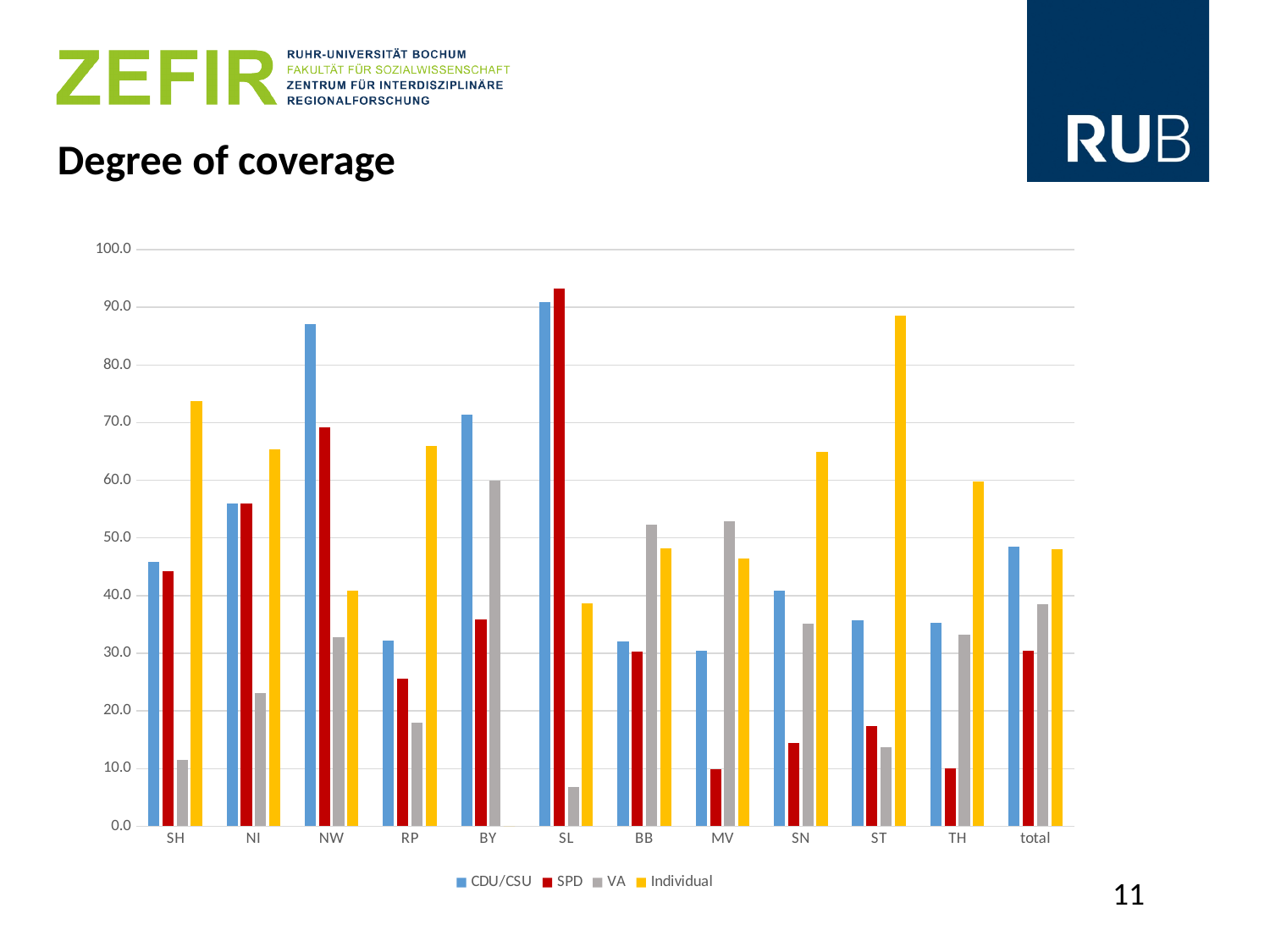
What kind of chart is shown on the slide? bar chart Is the VA value for SH greater or less than 20.0? less Which category has the highest value for the SPD series? SL Which category has the highest value for the Individual series? ST Which category has the lowest value for the VA series? SL What is the title of the chart on the slide? Degree of coverage How many series does the legend list? 4 Is the CDU/CSU value for NW greater or less than 80.0? greater For NW, which is larger: the CDU/CSU value or the SPD value? CDU/CSU Is the SPD value for MV greater or less than 20.0? less How many categories are shown along the x axis? 12